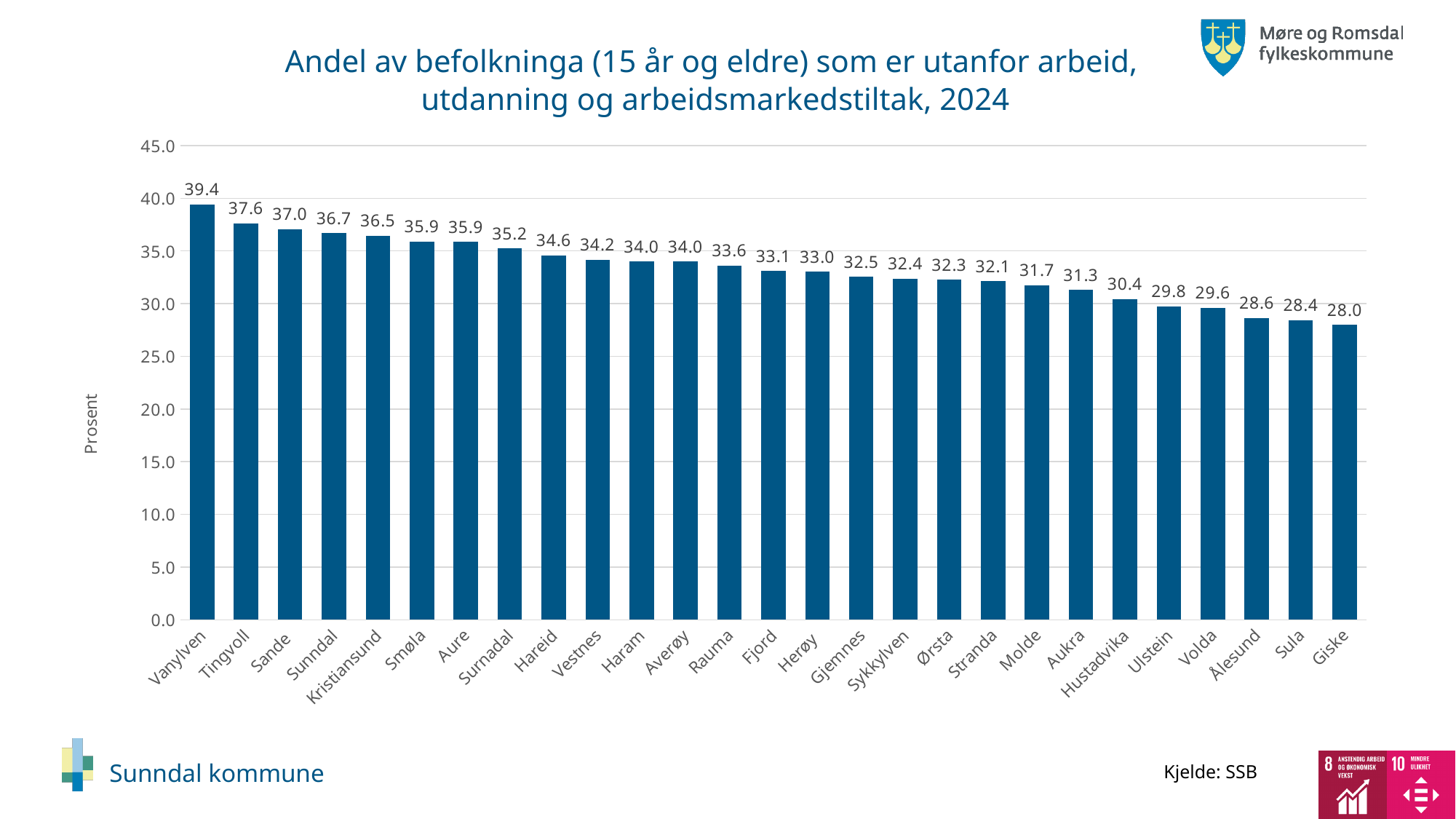
Which municipality has the highest value? Vanylven How many municipalities are shown in the chart? 27 Is the value for Hustadvika greater or less than 35.0? less What is the value for Sunndal? 36.7 What is the value for Giske? 28.0 Which municipality has the lowest value? Giske What kind of chart is shown on the slide? bar chart What is the difference between the values for Vanylven and Giske? 11.4 What is the difference between the values for Sunndal and Molde? 5.0 Which has a larger value, Kristiansund or Ålesund? Kristiansund What is the value for Molde? 31.7 What is the label on the vertical axis? Prosent